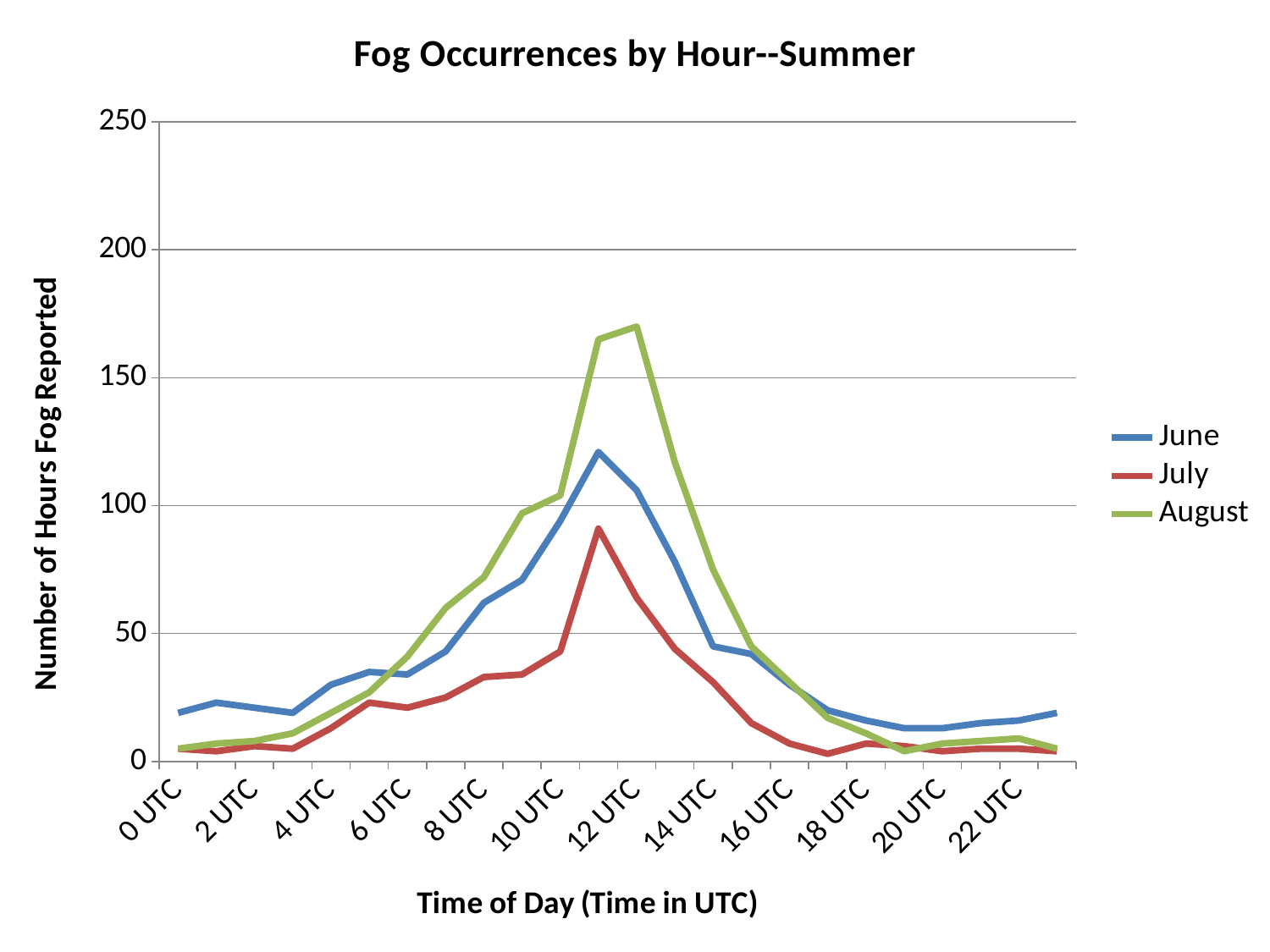
At 16 UTC, which is larger, the value for June or the value for July? June Is the value for June at 0 UTC greater or less than 50? less At 12 UTC, which series has the lowest value? July Does the August line rise or fall between 6 UTC and 12 UTC? rise Is the value for July at 12 UTC greater or less than 100? less Is the value for August at 12 UTC greater or less than 150? greater What is the title of the chart? Fog Occurrences by Hour--Summer Which series reaches the highest value on the chart? August At 0 UTC, which is larger, the value for June or the value for August? June What kind of chart is shown on the slide? line chart What is the label of the y axis? Number of Hours Fog Reported How many series does the legend list? 3